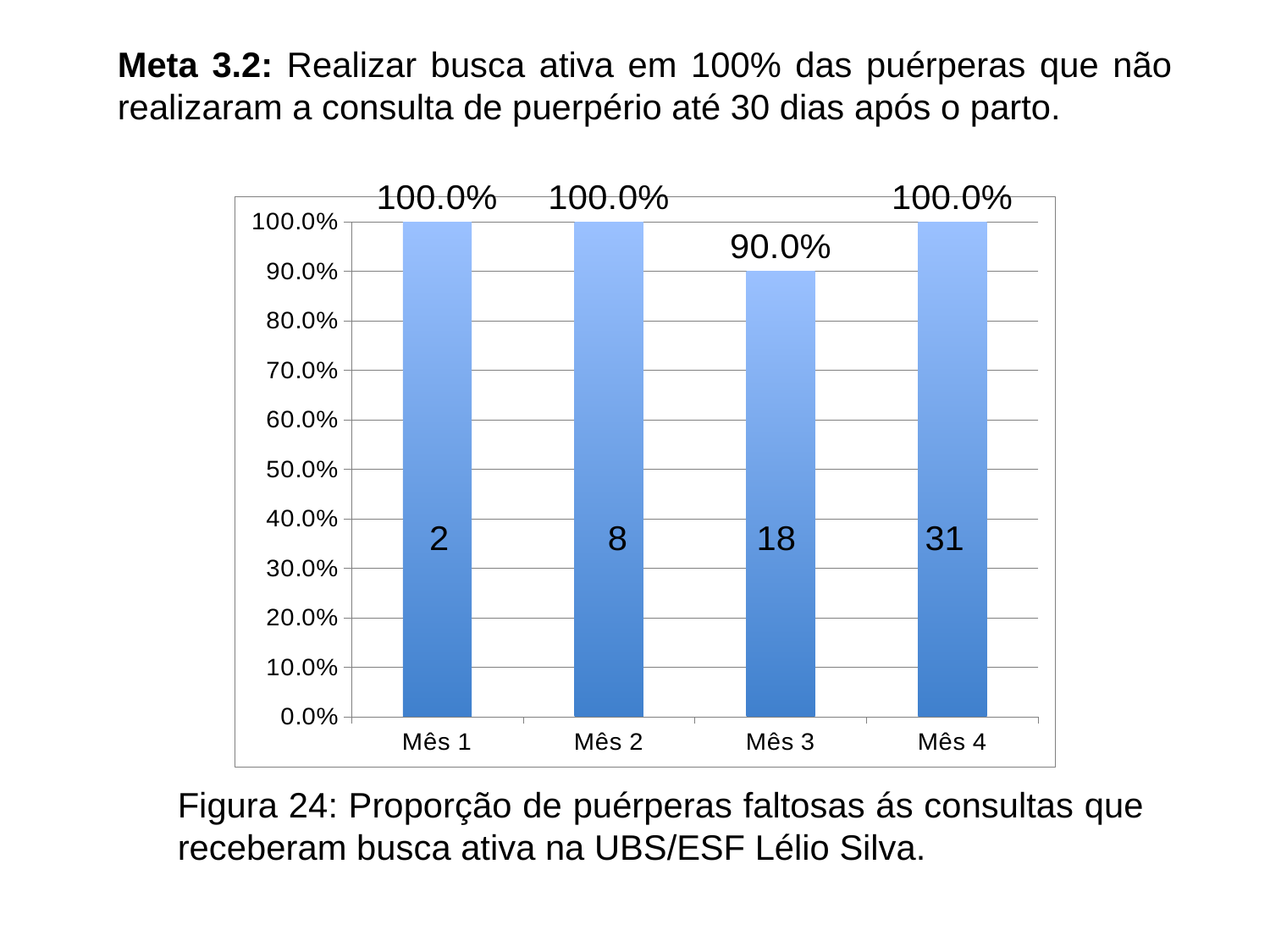
How many months (categories) are shown on the x axis? 4 What is the difference between the percentage values for Mês 2 and Mês 3? 10.0% What number is printed inside the bar for Mês 4? 31 What is the percentage value shown for Mês 1? 100.0% What kind of chart is shown on the slide? Bar chart Which is larger, the percentage value for Mês 3 or for Mês 4? Mês 4 What is the percentage value shown for Mês 3? 90.0% Is the percentage value for Mês 3 greater or less than 80.0%? greater What number is printed inside the bar for Mês 2? 8 Which month has the lowest percentage value? Mês 3 What is the figure number given in the caption below the chart? Figura 24 What is the difference between the numbers printed inside the bars for Mês 4 and Mês 3? 13